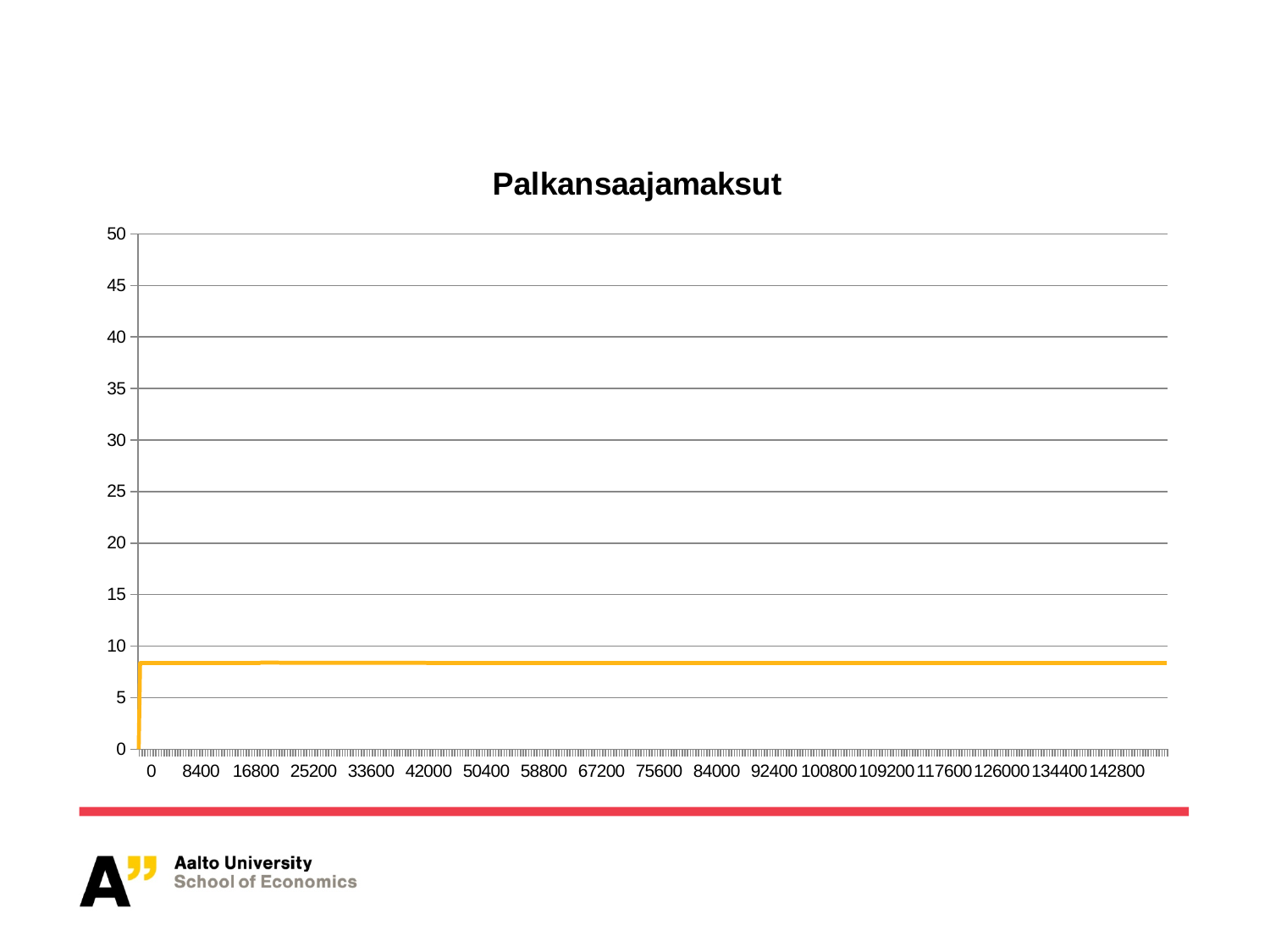
Is the value for 126000 greater or less than 20? less After the initial jump at 0, does the line rise, fall, or stay flat as the x-axis values increase? stay flat How many lines are plotted on the chart? 1 Is the value for 42000 greater or less than 5? greater Is the value for 84000 greater or less than 10? less What is the title of the chart? Palkansaajamaksut What kind of chart is shown on the slide? line chart What is the highest value shown on the y-axis? 50